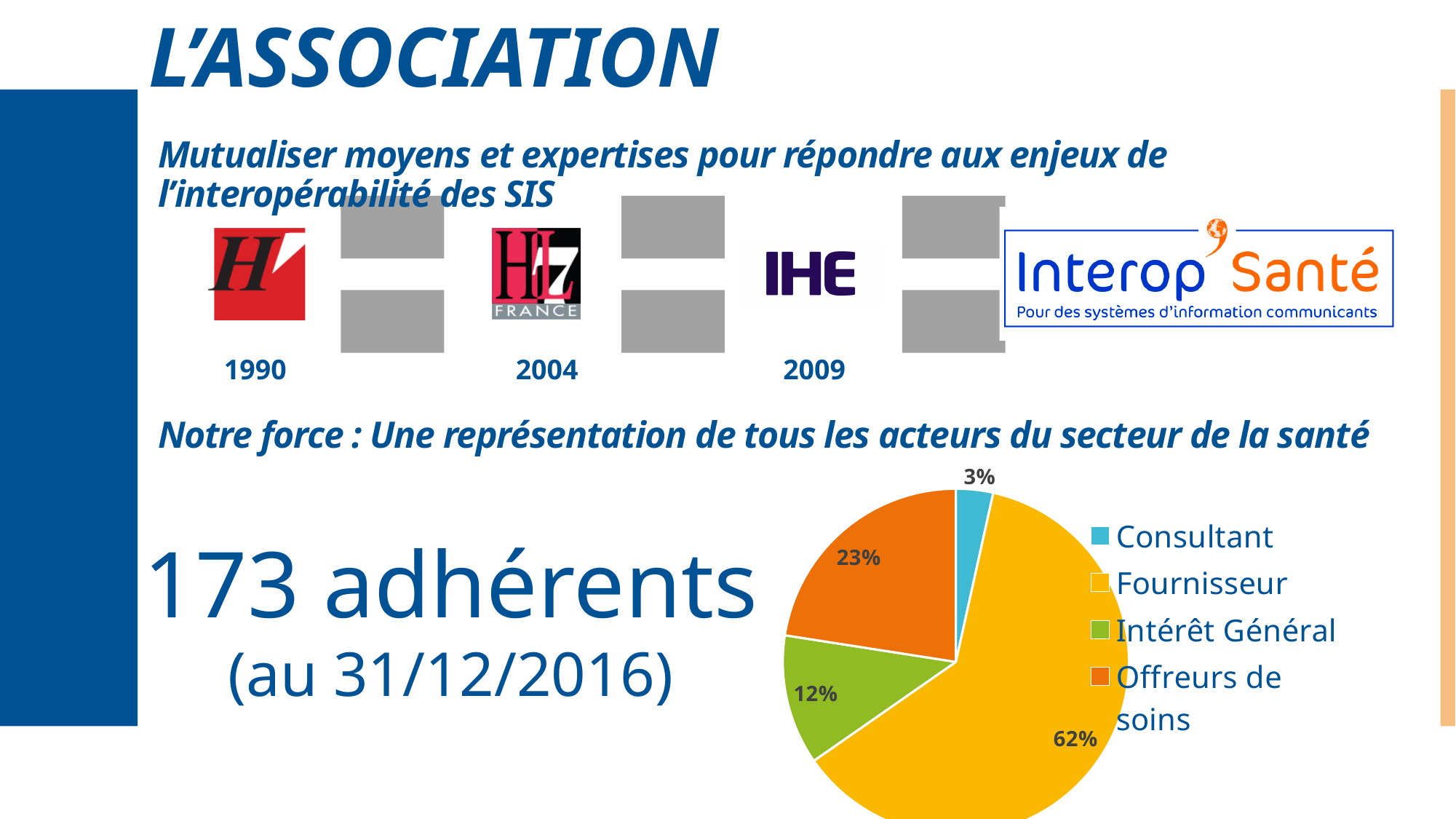
What share of the pie does Fournisseur represent? 62% What share of the pie does Intérêt Général represent? 12% What share of the pie does Consultant represent? 3% Which category has the largest slice of the pie? Fournisseur What colour is the Fournisseur slice? yellow Which is larger, the share for Intérêt Général or the share for Offreurs de soins? Offreurs de soins What kind of chart is shown on the slide? pie chart How many categories does the pie chart have? 4 What is the difference in percentage points between Fournisseur and Offreurs de soins? 39 Which category has the smallest slice of the pie? Consultant Which legend entry is shown in green? Intérêt Général